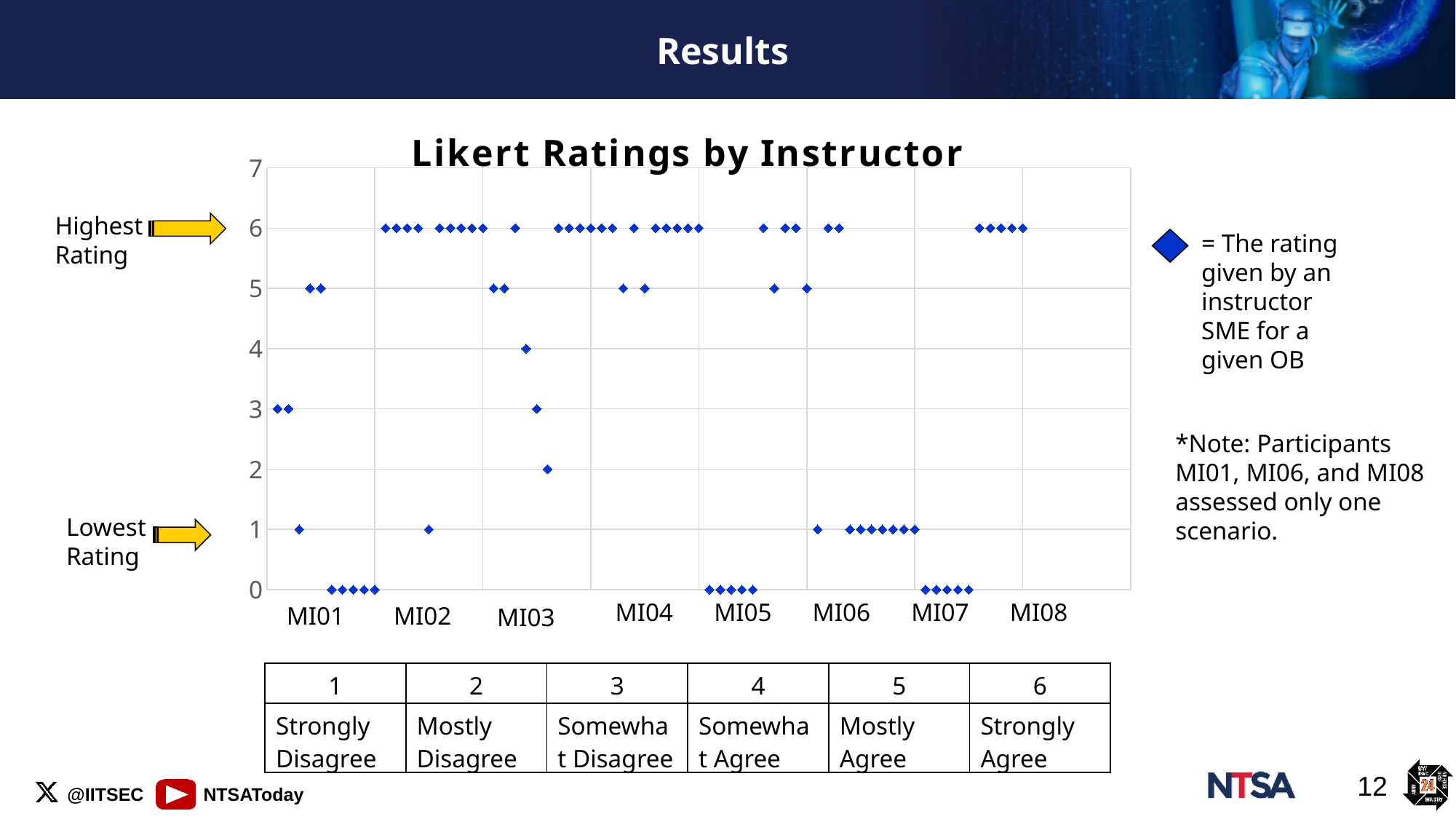
How many points are plotted at a rating of 2? 1 How many points are plotted at a rating of 4? 1 What is the title of the chart? Likert Ratings by Instructor What kind of chart is shown on the slide? Scatter plot What is the highest value shown on the y axis of the chart? 7 How many instructors are listed along the x axis of the chart? 8 What is the lowest rating value at which any point is plotted? 0 According to the table below the chart, what does a rating of 1 mean? Strongly Disagree Is the highest plotted rating greater or less than 7? less According to the table below the chart, what does a rating of 6 mean? Strongly Agree Which rating value has the most points plotted on it? 6 What is the highest rating value at which any point is plotted? 6